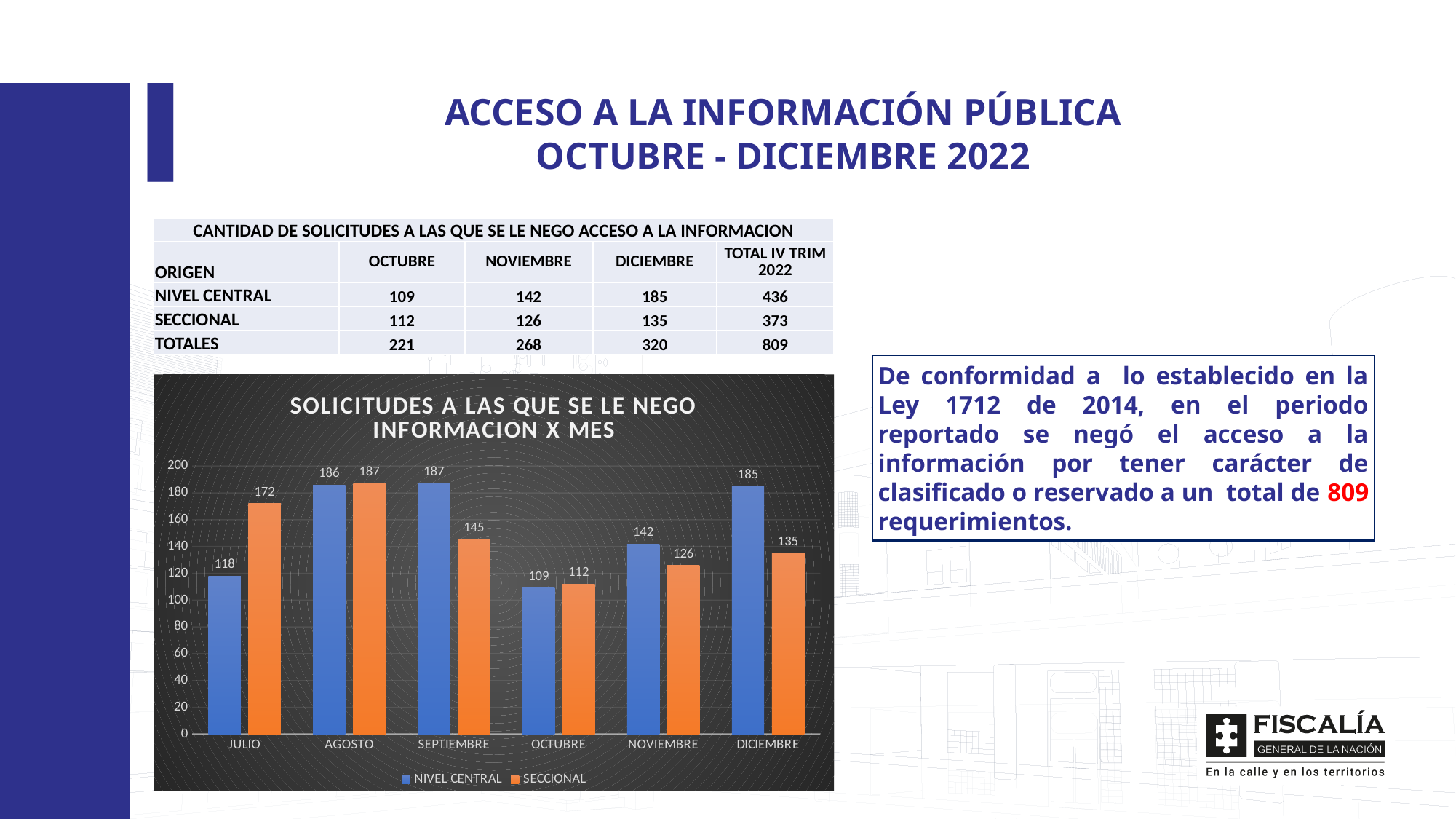
Which month has the lowest value for NIVEL CENTRAL? OCTUBRE What is the difference between SECCIONAL and NIVEL CENTRAL in JULIO? 54 Do the NIVEL CENTRAL values rise or fall from OCTUBRE to DICIEMBRE? Rise What is the value for SECCIONAL in DICIEMBRE? 135 What kind of chart is shown on the slide? Bar chart How many series does the chart legend list? 2 What is the value for SECCIONAL in SEPTIEMBRE? 145 In NOVIEMBRE, which series has the larger value, NIVEL CENTRAL or SECCIONAL? NIVEL CENTRAL Is the value for NIVEL CENTRAL in DICIEMBRE greater or less than 160? greater Which month has the highest value for SECCIONAL? AGOSTO How many months are shown on the x axis of the chart? 6 What is the value for NIVEL CENTRAL in JULIO? 118